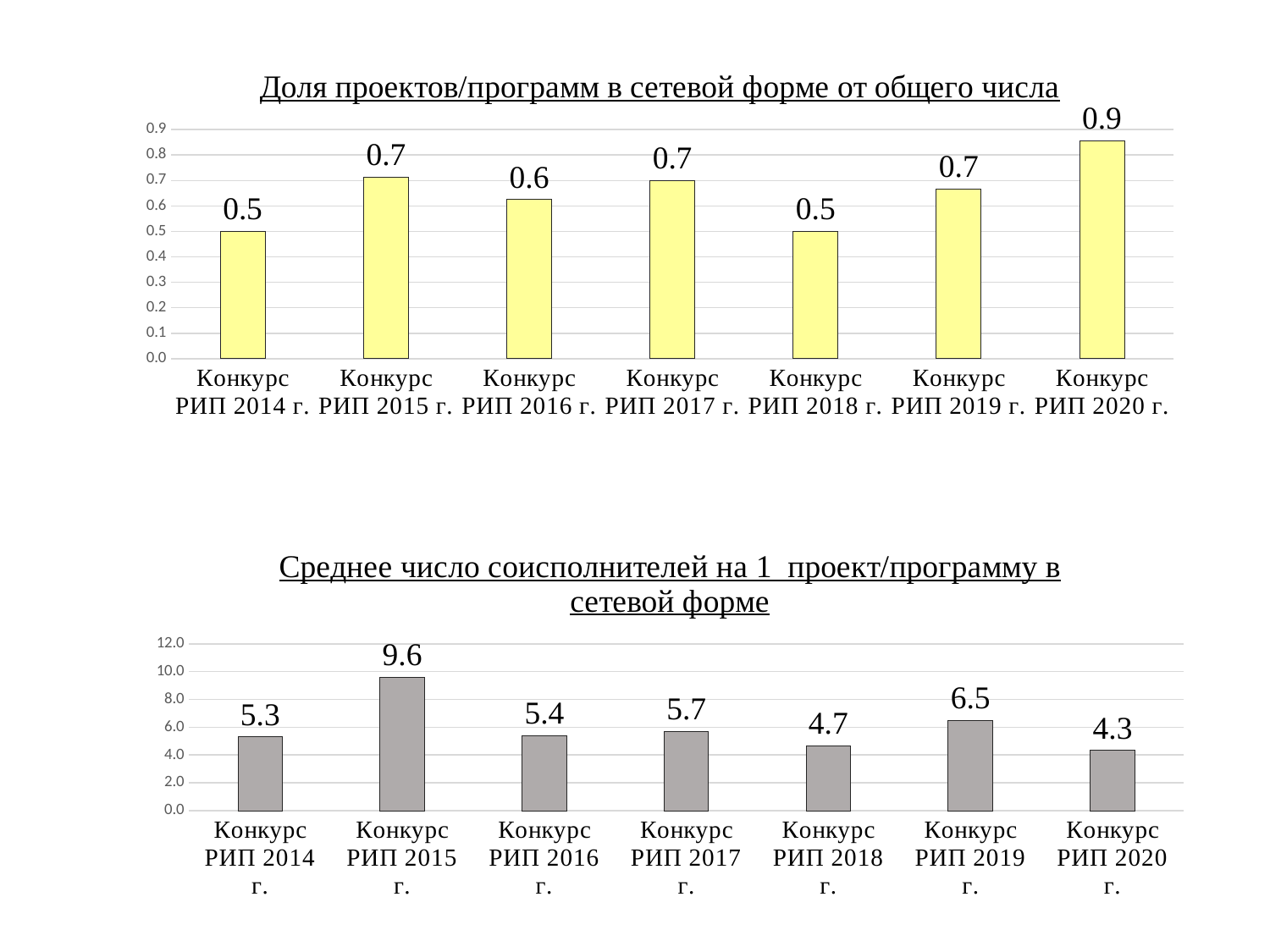
In the top chart (Доля проектов/программ в сетевой форме от общего числа), how many categories are shown? 7 In the bottom chart (Среднее число соисполнителей на 1 проект/программу в сетевой форме), what is the difference between the values for Конкурс РИП 2015 г. and Конкурс РИП 2014 г.? 4.3 In the bottom chart (Среднее число соисполнителей на 1 проект/программу в сетевой форме), which category has the lowest value? Конкурс РИП 2020 г. In the bottom chart (Среднее число соисполнителей на 1 проект/программу в сетевой форме), what is the value for Конкурс РИП 2019 г.? 6.5 In the top chart (Доля проектов/программ в сетевой форме от общего числа), what is the value for Конкурс РИП 2016 г.? 0.6 In the bottom chart (Среднее число соисполнителей на 1 проект/программу в сетевой форме), which is larger: the value for Конкурс РИП 2017 г. or Конкурс РИП 2018 г.? Конкурс РИП 2017 г. In the top chart (Доля проектов/программ в сетевой форме от общего числа), what is the difference between the values for Конкурс РИП 2020 г. and Конкурс РИП 2014 г.? 0.4 In the bottom chart (Среднее число соисполнителей на 1 проект/программу в сетевой форме), which category has the highest value? Конкурс РИП 2015 г. In the bottom chart (Среднее число соисполнителей на 1 проект/программу в сетевой форме), what is the value for Конкурс РИП 2015 г.? 9.6 In the top chart (Доля проектов/программ в сетевой форме от общего числа), what kind of chart is it? Bar chart In the top chart (Доля проектов/программ в сетевой форме от общего числа), what is the value for Конкурс РИП 2020 г.? 0.9 In the top chart (Доля проектов/программ в сетевой форме от общего числа), which category has the highest value? Конкурс РИП 2020 г.